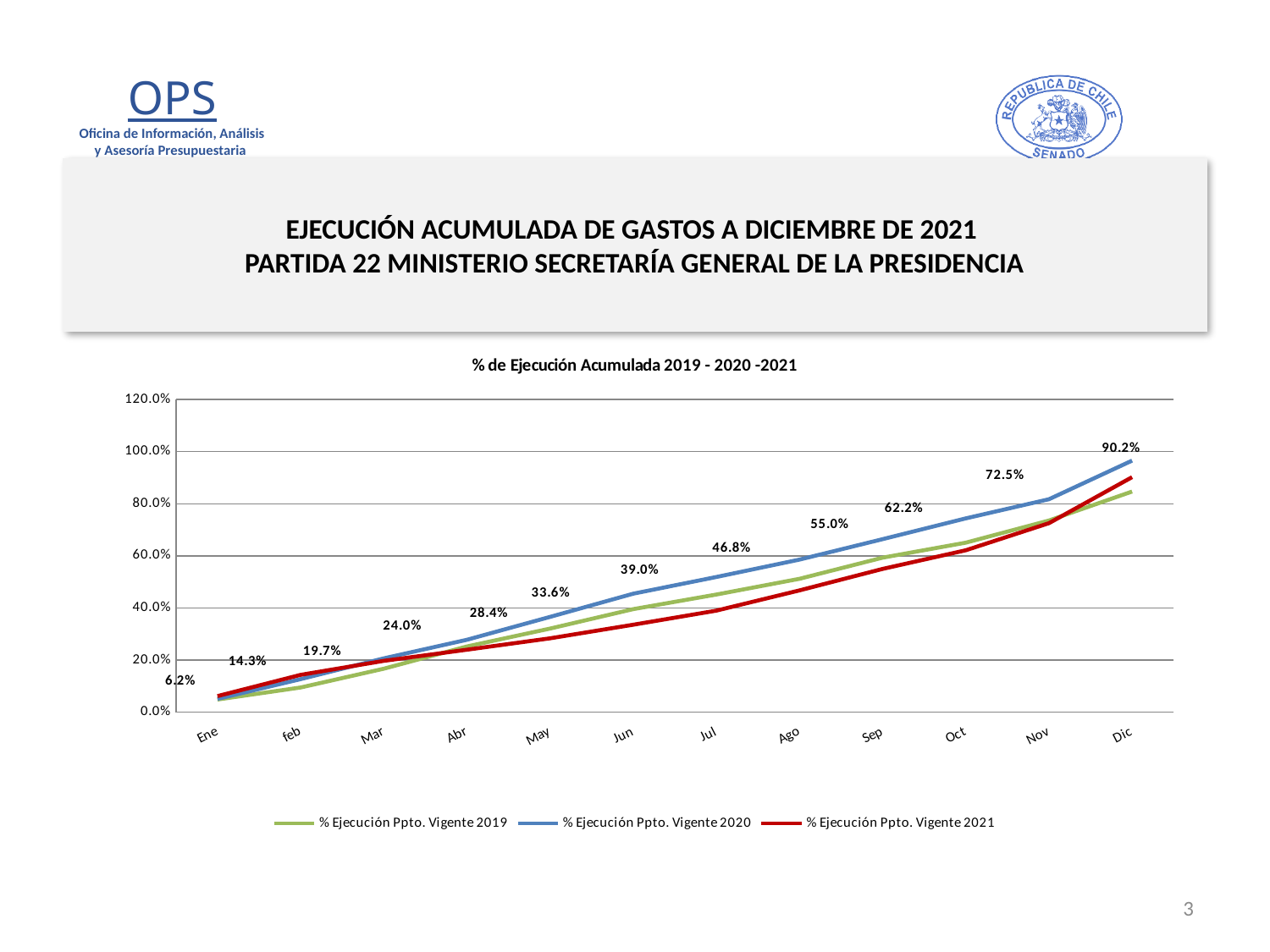
What is the difference between the 2021 values for Ago (46.8%) and Jul (39.0%)? 7.8% What is the title of the chart? % de Ejecución Acumulada 2019 - 2020 -2021 How many months are plotted along the x axis? 12 What is the labelled value for % Ejecución Ppto. Vigente 2021 in Ene? 6.2% What is the labelled value for % Ejecución Ppto. Vigente 2021 in Dic? 90.2% What kind of chart is shown on the slide? line chart What is the labelled value for % Ejecución Ppto. Vigente 2021 in Jun? 33.6% By how many percentage points does the 2021 series rise from Nov (72.5%) to Dic (90.2%)? 17.7% Is the value for % Ejecución Ppto. Vigente 2020 in Sep greater or less than 60.0%? greater Do the values of the series rise or fall from Ene to Dic? rise How many series does the legend list? 3 In Dic, which series is higher: % Ejecución Ppto. Vigente 2020 or % Ejecución Ppto. Vigente 2021? % Ejecución Ppto. Vigente 2020